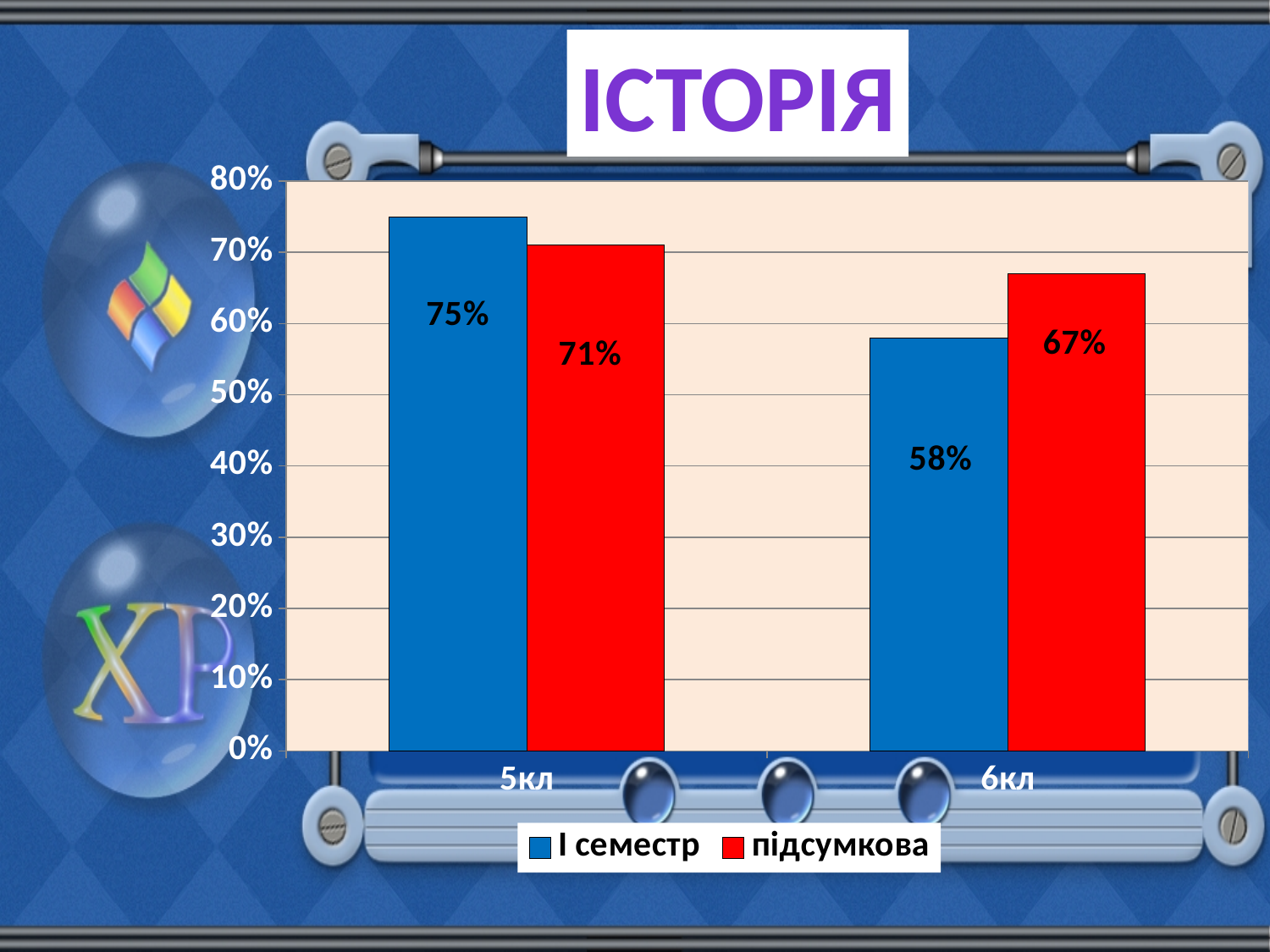
What kind of chart is shown on the slide? bar chart Which is larger for 5кл: І семестр or підсумкова? І семестр What is the difference between the І семестр values for 5кл and 6кл? 17% Which category has the highest І семестр value? 5кл What is the value for підсумкова for 6кл? 67% How many categories are shown on the x axis? 2 What is the value for І семестр for 6кл? 58% How many series does the legend list? 2 Which category has the lowest підсумкова value? 6кл What is the value for І семестр for 5кл? 75% What is the value for підсумкова for 5кл? 71% What is the difference between the підсумкова and І семестр values for 6кл? 9%